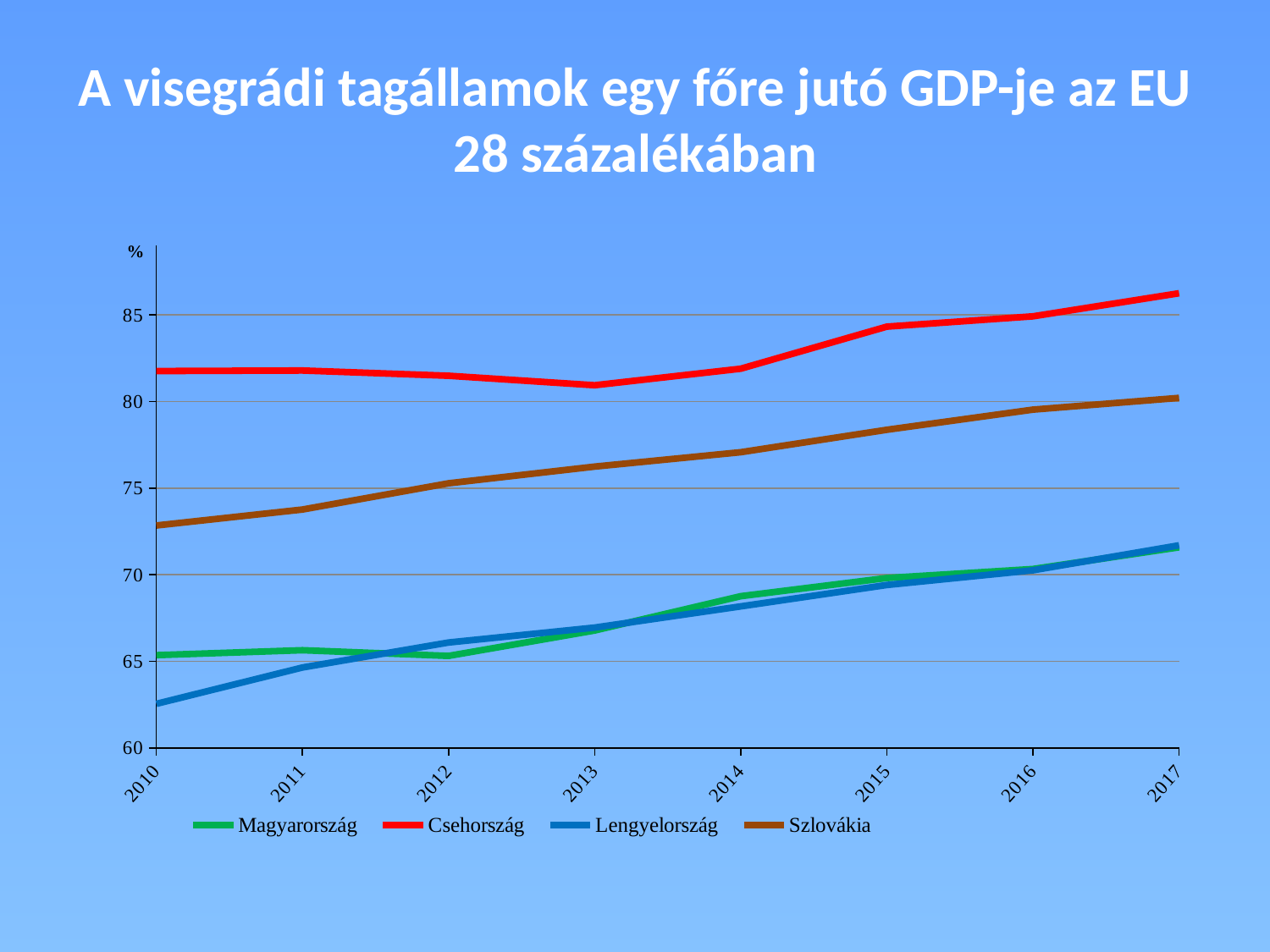
How many series does the legend list? 4 Is the value for Csehország in 2017 greater or less than 85? greater Which is larger in 2010, the value for Magyarország or the value for Lengyelország? Magyarország Which colour is used for the Csehország line? red Which country has the lowest value in 2010? Lengyelország How many years are shown on the x axis? 8 Is the value for Lengyelország in 2010 greater or less than 65? less Is the value for Szlovákia in 2010 greater or less than 75? less Which country has the highest value in 2017? Csehország What kind of chart is shown on the slide? line chart Does the value for Szlovákia rise or fall from 2010 to 2017? rise